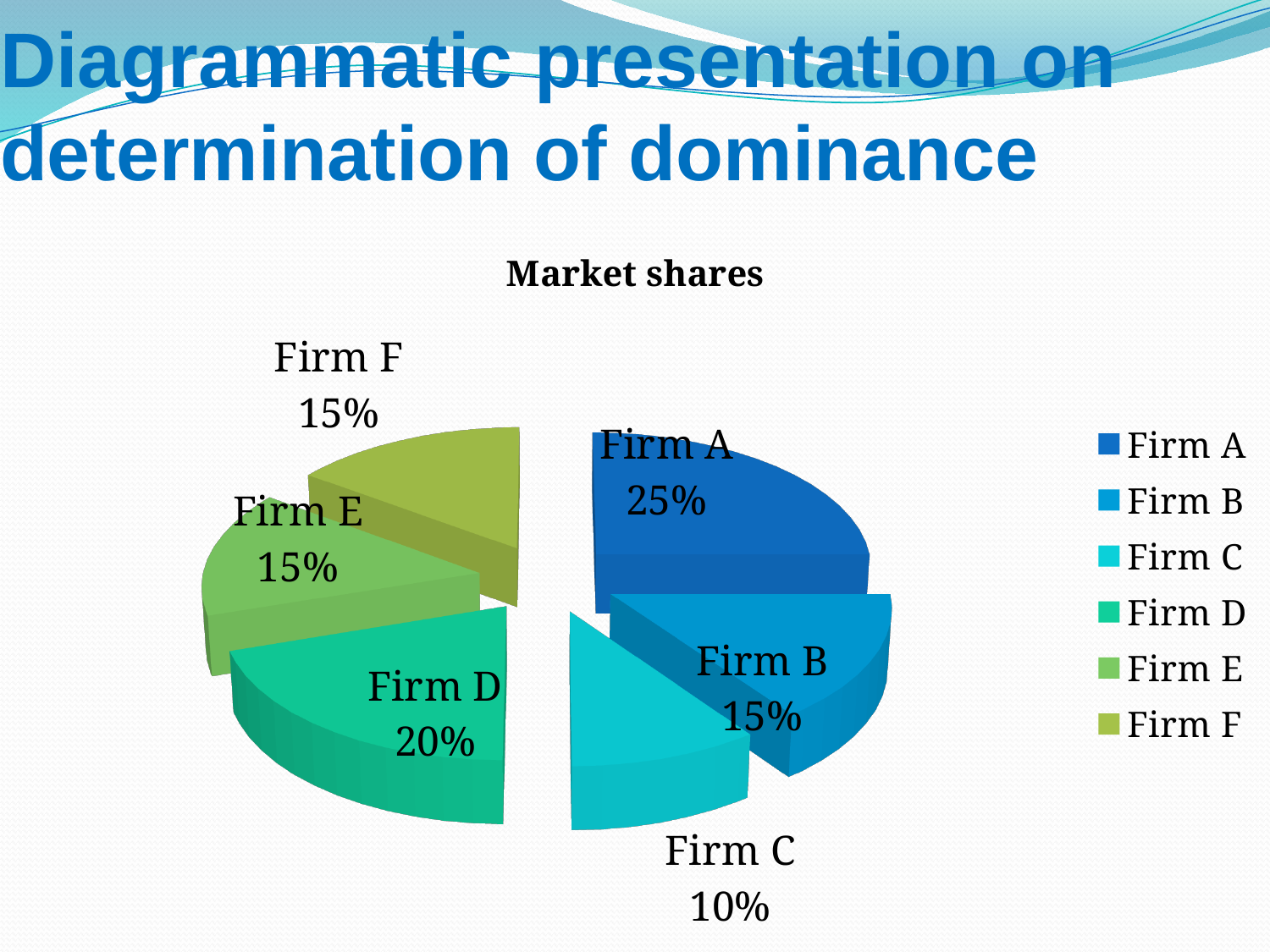
How many firms are shown in the pie chart? 6 Which firm has the largest market share? Firm A What kind of chart is shown on the slide? pie chart What is the market share of Firm C? 10% Which has a larger market share, Firm D or Firm B? Firm D How many entries does the legend list? 6 What is the market share of Firm D? 20% What is the market share of Firm A? 25% What is the combined market share of Firm E and Firm F? 30% What is the title of the chart? Market shares Which firm has the smallest market share? Firm C What is the difference between the market shares of Firm A and Firm C? 15%